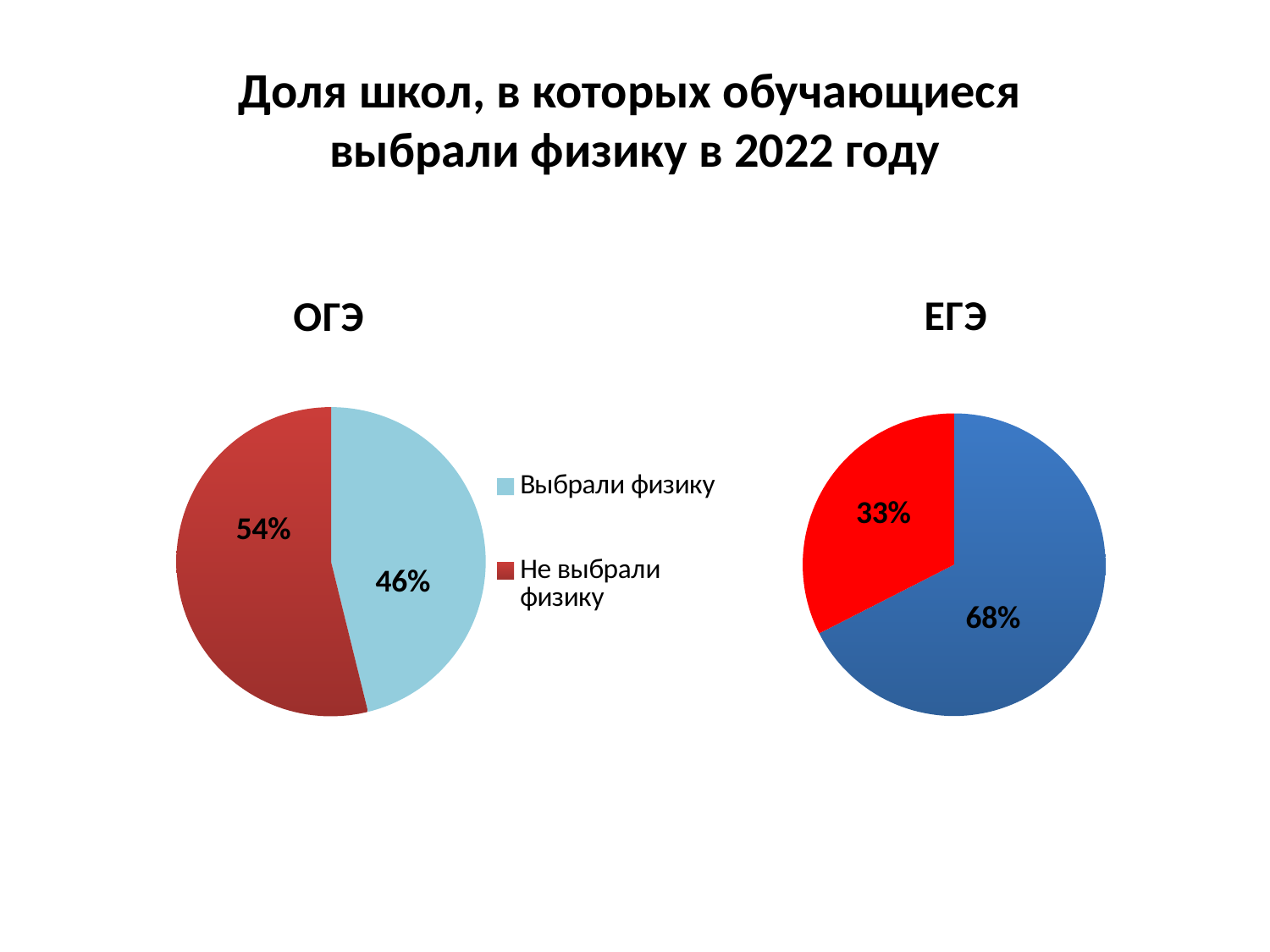
In the ОГЭ chart, which category has the larger slice? Не выбрали физику How many entries does the legend next to the ОГЭ chart list? 2 In the ОГЭ chart, which category has the smaller slice? Выбрали физику In the ОГЭ chart, what share of schools is labelled "Не выбрали физику"? 54% In the ОГЭ chart, what share of schools is labelled "Выбрали физику"? 46% In the ОГЭ chart, what is the difference between the "Не выбрали физику" and "Выбрали физику" shares? 8% In the ЕГЭ chart, which slice is larger, the blue one or the red one? the blue one What kind of chart is the ОГЭ chart? pie chart In the ЕГЭ chart, what value is printed on the red slice? 33% What is the title of the slide above the two pie charts? Доля школ, в которых обучающиеся выбрали физику в 2022 году How many slices does the ОГЭ pie chart have? 2 In the ЕГЭ chart, what value is printed on the blue slice? 68%